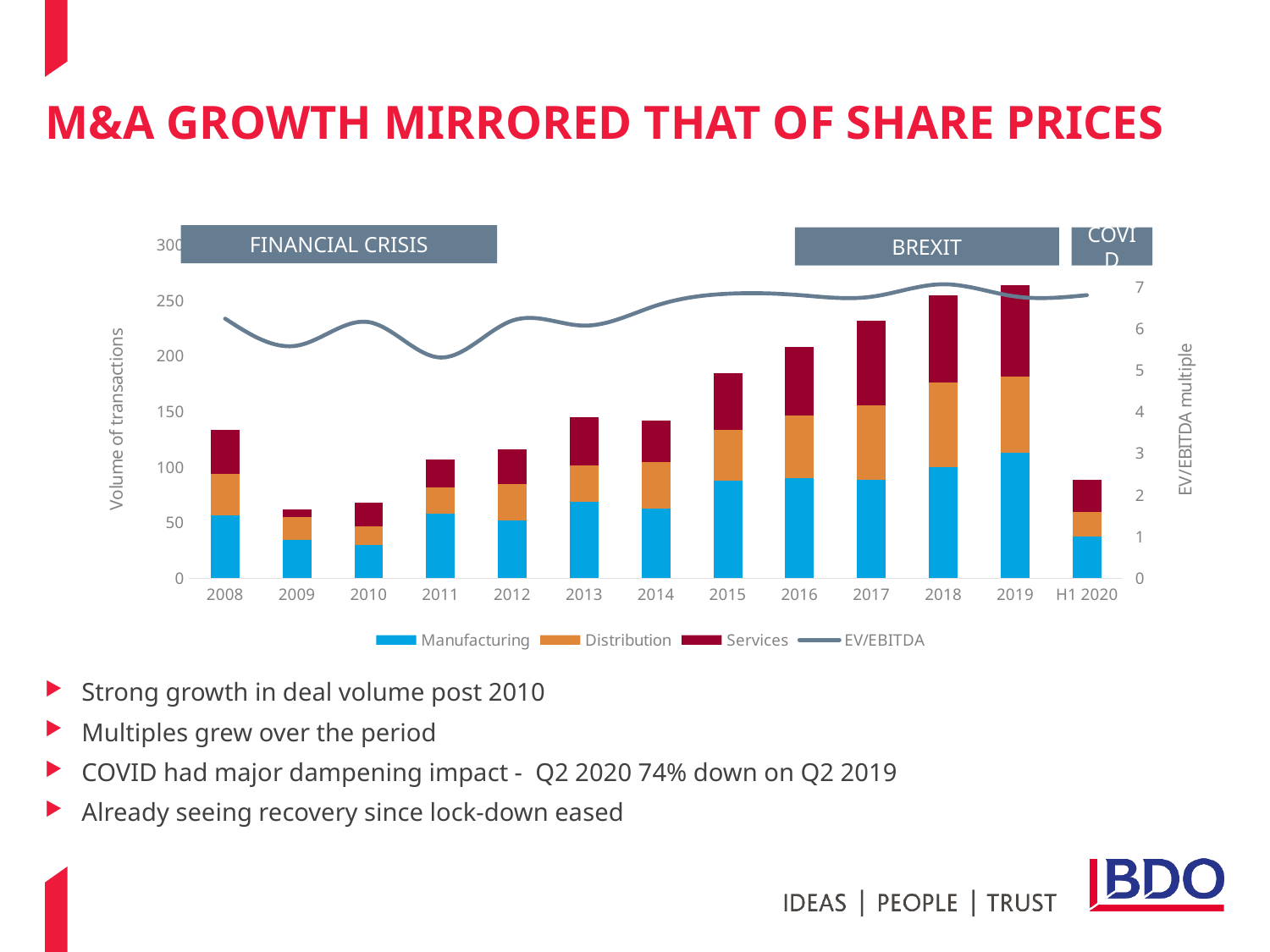
Is the total volume of transactions for 2019 greater or less than 250? greater Which year has the lowest total volume of transactions? 2009 How many categories are shown on the x axis of the chart? 13 Do the total volumes of transactions rise or fall from 2010 to 2019? rise Is the total volume of transactions for H1 2020 greater or less than 100? less Is the total volume of transactions for 2015 greater or less than 200? less What kind of chart is shown on the slide? combination bar and line chart Which year has the highest total volume of transactions? 2019 Which year has a larger total volume of transactions, 2014 or 2017? 2017 How many series does the chart's legend list? 4 What is the label of the right-hand vertical axis? EV/EBITDA multiple